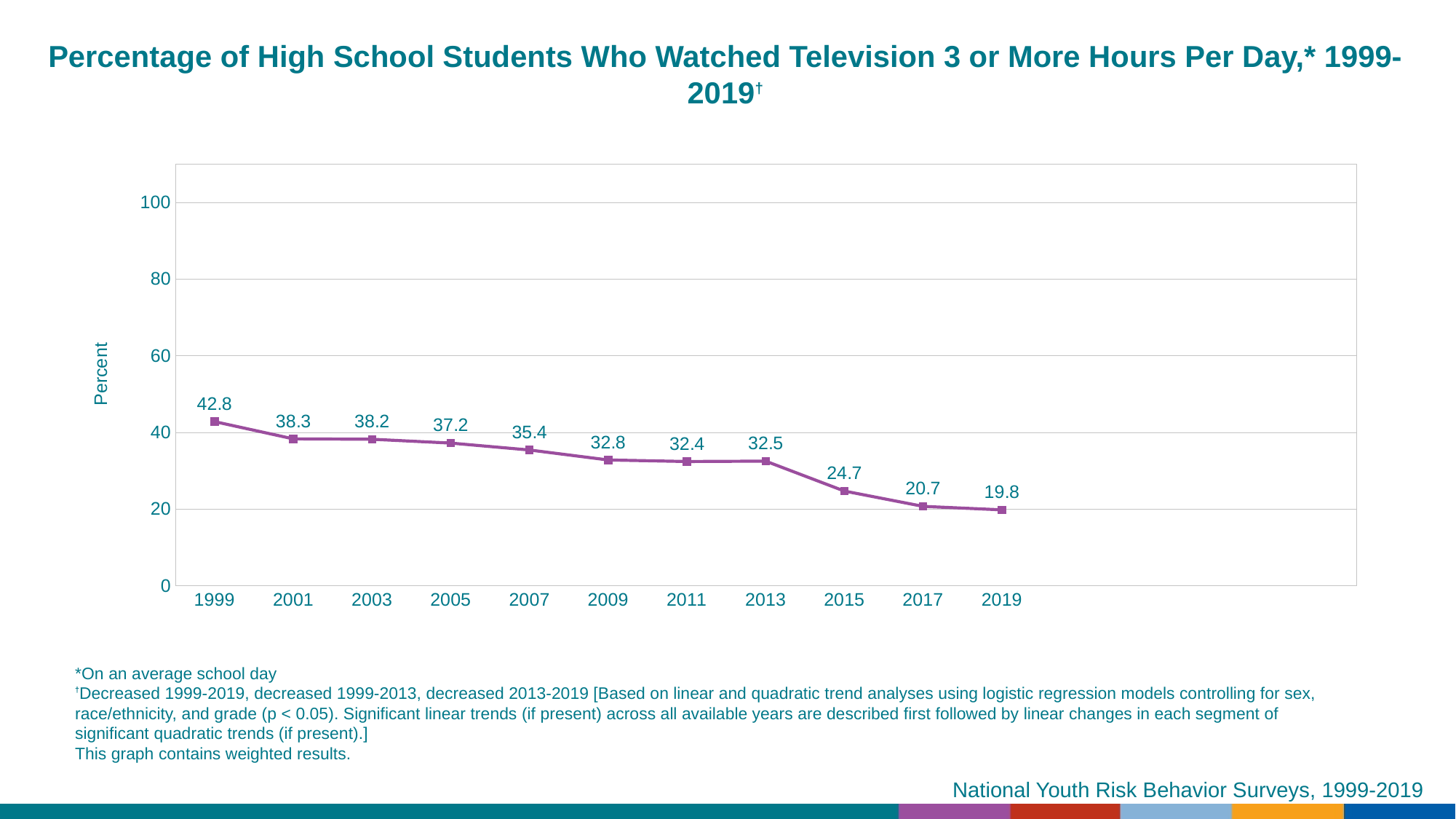
What percentage of high school students watched television 3 or more hours per day in 1999? 42.8 What is the difference between the 2013 value and the 2015 value? 7.8 What kind of chart is shown on the slide? line chart What is the value plotted for 2019? 19.8 How many years are plotted on the x axis? 11 Which year has the highest percentage? 1999 What is the value plotted for 2015? 24.7 Do the values rise or fall from 1999 to 2019? fall Is the value for 2017 greater or less than 40? less Which year has the lowest percentage? 2019 What is the difference between the 1999 value and the 2019 value? 23 Which is larger, the value for 2007 or the value for 2009? 2007